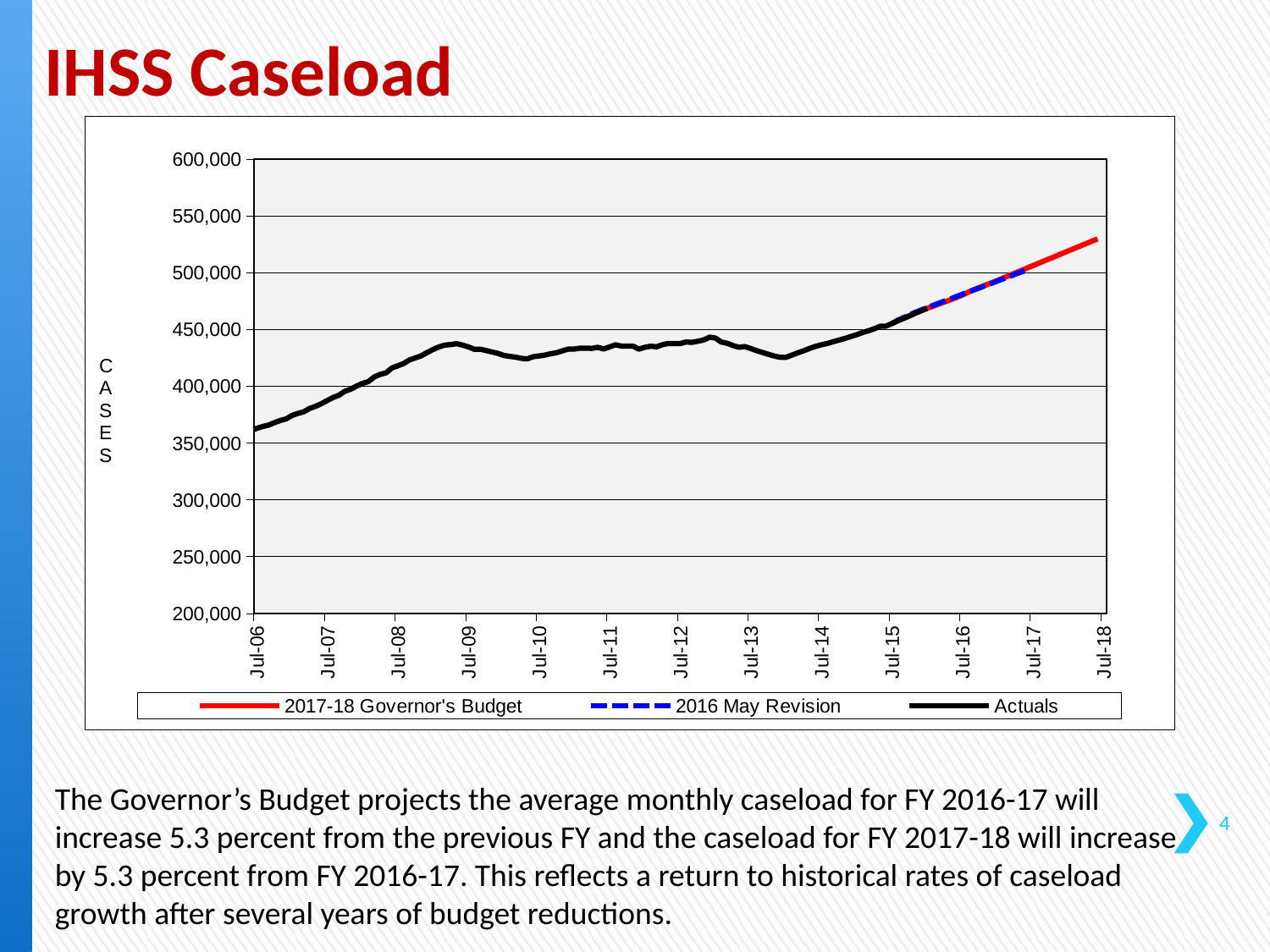
Is the Actuals value at Jul-09 greater or less than 400,000? greater Which is larger, the Actuals value at Jul-06 or at Jul-14? Jul-14 Is the 2017-18 Governor's Budget value at Jul-16 greater or less than 450,000? greater Is the 2017-18 Governor's Budget value at Jul-18 greater or less than 500,000? greater What are the three series named in the legend? 2017-18 Governor's Budget, 2016 May Revision, Actuals What kind of chart is shown on the slide? line chart Does the 2017-18 Governor's Budget line rise or fall from Jul-15 to Jul-18? rise What label is shown on the vertical axis? CASES How many series does the legend list? 3 How many labelled tick marks are on the x axis, from Jul-06 to Jul-18? 13